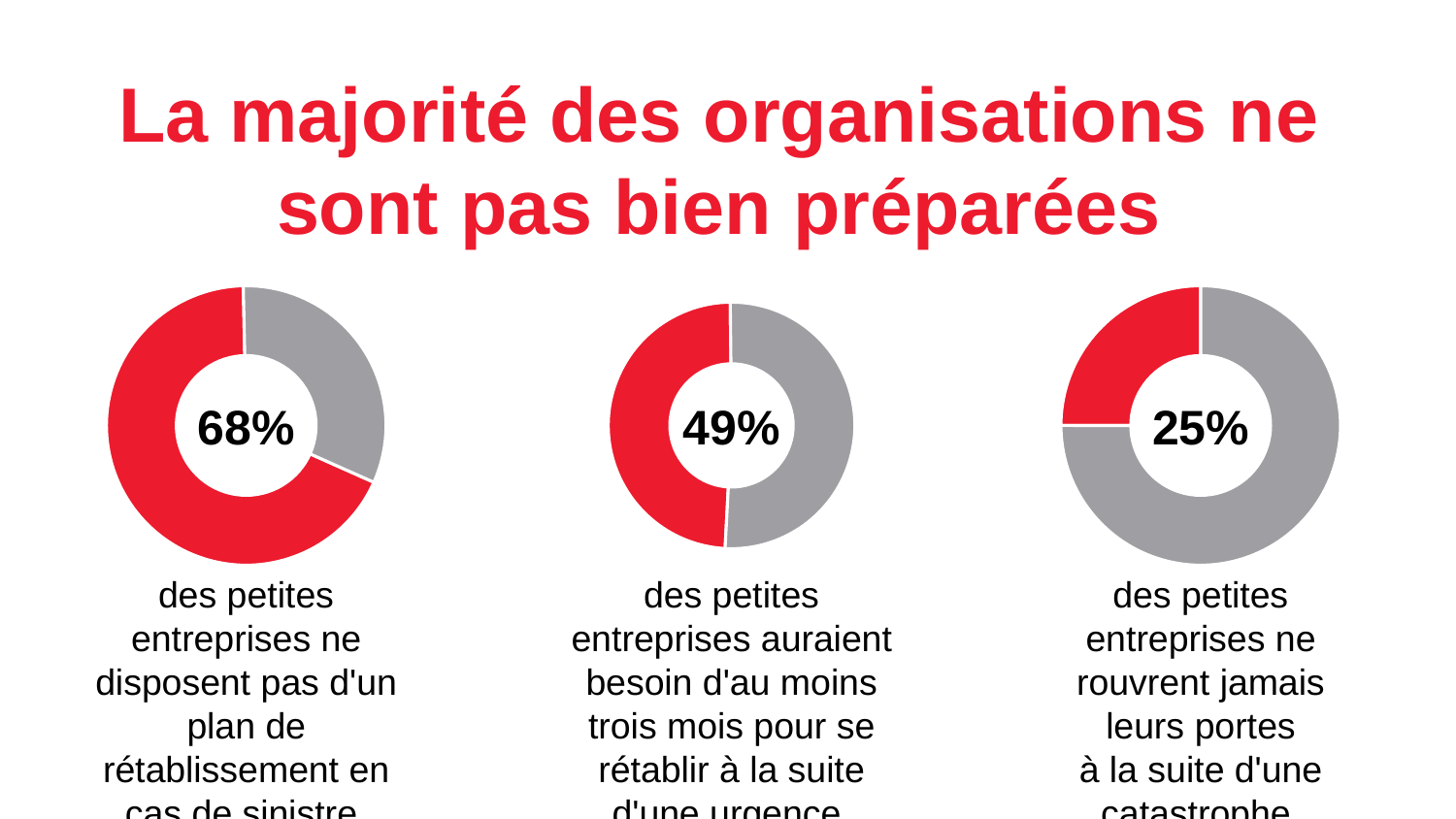
What percentage is shown in the centre of the middle donut chart? 49% What percentage is shown in the centre of the left donut chart? 68% What is the title of the slide? La majorité des organisations ne sont pas bien préparées Which donut chart shows the highest percentage? the left chart (68%) What colour is the highlighted slice in each donut chart? red What kind of chart is used on the left of the slide? donut chart How many donut charts are shown on the slide? 3 In the right donut chart, what share of the ring is grey? 75% Which donut chart shows the lowest percentage? the right chart (25%) What is the difference between the percentage in the left donut chart and the percentage in the right donut chart? 43 percentage points What percentage is shown in the centre of the right donut chart? 25% Which is larger: the percentage in the middle donut chart or the percentage in the right donut chart? the middle chart (49%)